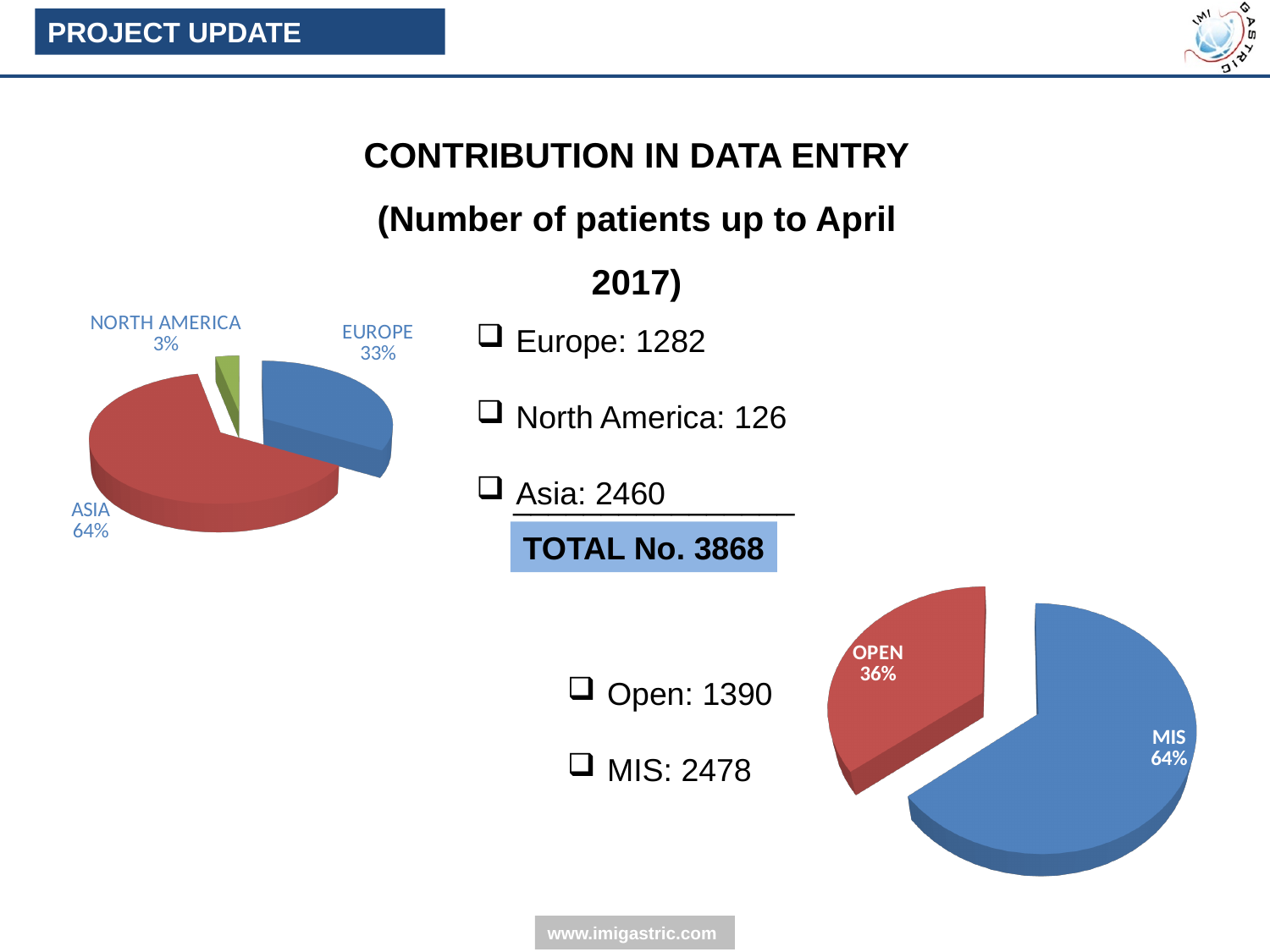
In the bottom-right pie chart, what share does Open have? 36% In the bottom-right pie chart, what colour is the MIS slice? blue In the left pie chart, what is the difference in percentage points between Asia and Europe? 31 How many slices does the left pie chart have? 3 In the bottom-right pie chart, what share does MIS have? 64% In the left pie chart, what share does Europe have? 33% In the left pie chart, which region has the largest slice? Asia In the left pie chart, which region has the smallest slice? North America What kind of chart is the chart on the left of the slide? pie chart In the bottom-right pie chart, which slice is larger, Open or MIS? MIS